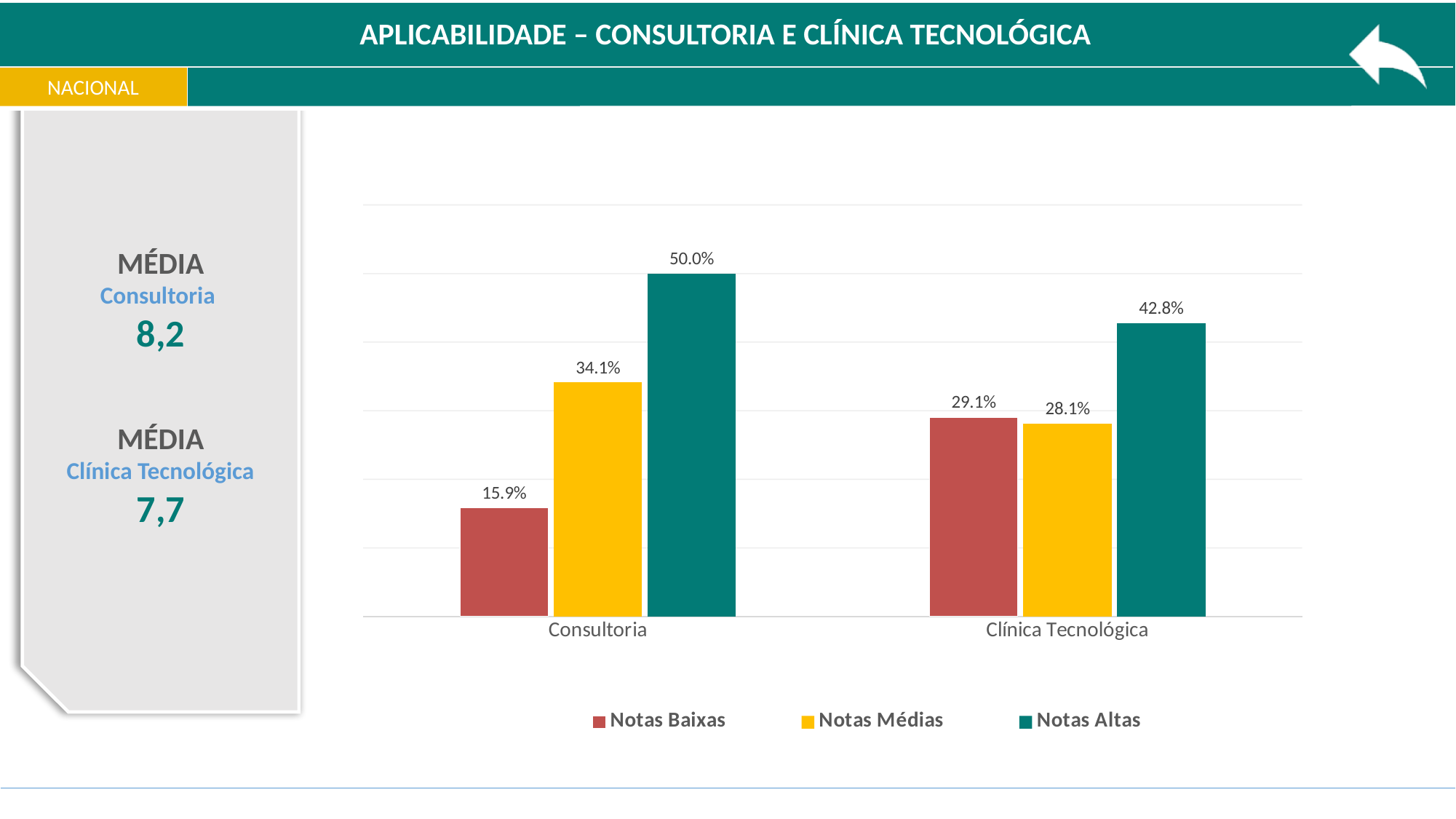
How many categories are shown on the x axis of the chart? 2 What is the value of Notas Altas for Clínica Tecnológica? 42.8% What is the difference between Notas Altas and Notas Baixas for Consultoria? 34.1% What is the value of Notas Médias for Consultoria? 34.1% What is the value of Notas Altas for Consultoria? 50.0% What is the value of Notas Baixas for Clínica Tecnológica? 29.1% What kind of chart is shown on the slide? Bar chart How many series does the chart legend list? 3 Which series has the lowest value for Consultoria? Notas Baixas What is the difference between Notas Altas for Consultoria and Notas Altas for Clínica Tecnológica? 7.2% Which is larger: Notas Baixas for Consultoria or Notas Baixas for Clínica Tecnológica? Clínica Tecnológica Which series has the highest value for Consultoria? Notas Altas